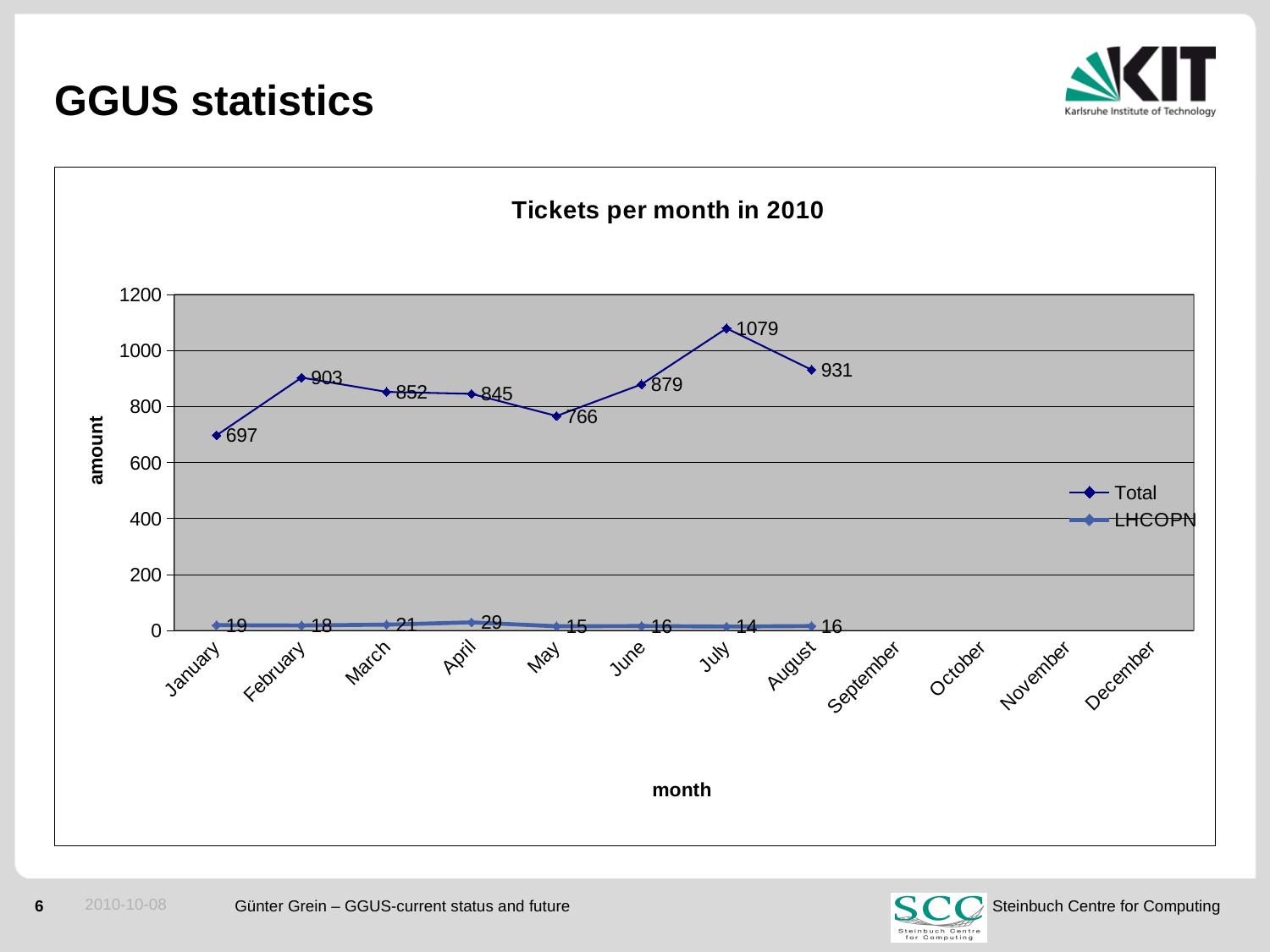
Is the Total value for May greater or less than 800? less How many months have data points plotted for the Total series? 8 What is the difference between the Total values for July and August? 148 What is the Total value for July? 1079 What is the LHCOPN value for April? 29 Which is larger, the Total value for February or the Total value for June? February What type of chart is shown on the slide? line chart What is the Total value for January? 697 How many series does the legend list? 2 Which month has the lowest LHCOPN value? July Which month has the highest Total value? July What is the title of the chart? Tickets per month in 2010